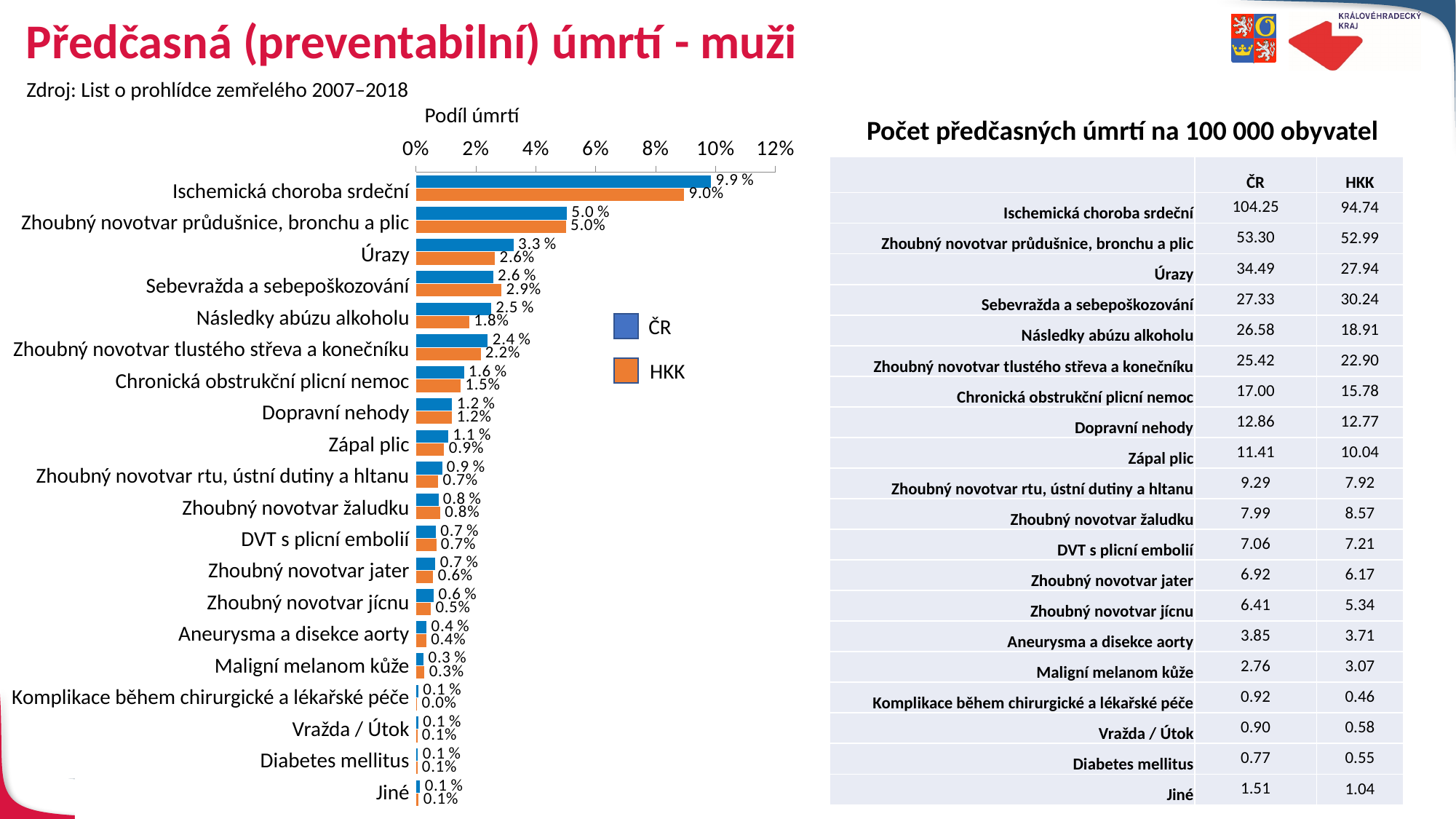
What is the axis title shown above the bar chart? Podíl úmrtí How many categories are shown in the bar chart? 20 What is the ČR value for Ischemická choroba srdeční in the bar chart? 9.9 % For Sebevražda a sebepoškozování, which series has the larger value in the bar chart, ČR or HKK? HKK What is the HKK value for Úrazy in the bar chart? 2.6% What is the HKK value for Sebevražda a sebepoškozování in the bar chart? 2.9% How many series does the legend of the bar chart list? 2 Is the ČR value for Ischemická choroba srdeční greater or less than 8%? greater Which category has the highest ČR value in the bar chart? Ischemická choroba srdeční What type of chart is shown on the left of the slide? Bar chart What is the ČR value for Následky abúzu alkoholu in the bar chart? 2.5 % What is the difference between the ČR and HKK values for Ischemická choroba srdeční in the bar chart? 0.9 percentage points